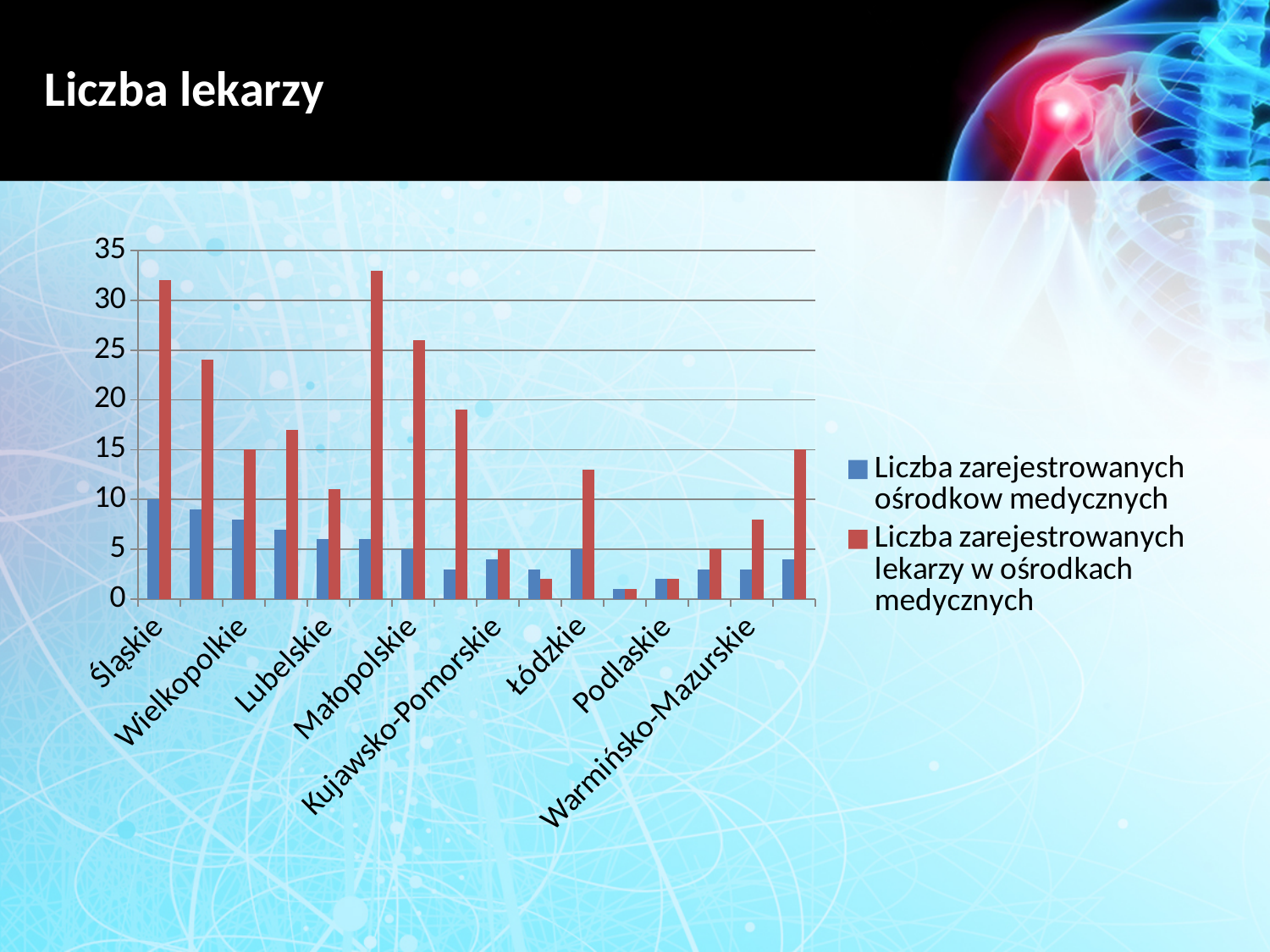
Is the value of Liczba zarejestrowanych lekarzy w ośrodkach medycznych for Małopolskie greater or less than 20? greater Is the value of Liczba zarejestrowanych lekarzy w ośrodkach medycznych for Śląskie greater or less than 30? greater Which has more registered doctors (Liczba zarejestrowanych lekarzy w ośrodkach medycznych): Śląskie or Wielkopolskie? Śląskie How many series does the chart legend list? 2 Which has more registered medical centres (Liczba zarejestrowanych ośrodkow medycznych): Śląskie or Lubelskie? Śląskie Is the value of Liczba zarejestrowanych lekarzy w ośrodkach medycznych for Lubelskie greater or less than 15? less Which series is shown in red in the chart? Liczba zarejestrowanych lekarzy w ośrodkach medycznych Which series is shown in blue in the chart? Liczba zarejestrowanych ośrodkow medycznych What kind of chart is shown on the slide? bar chart